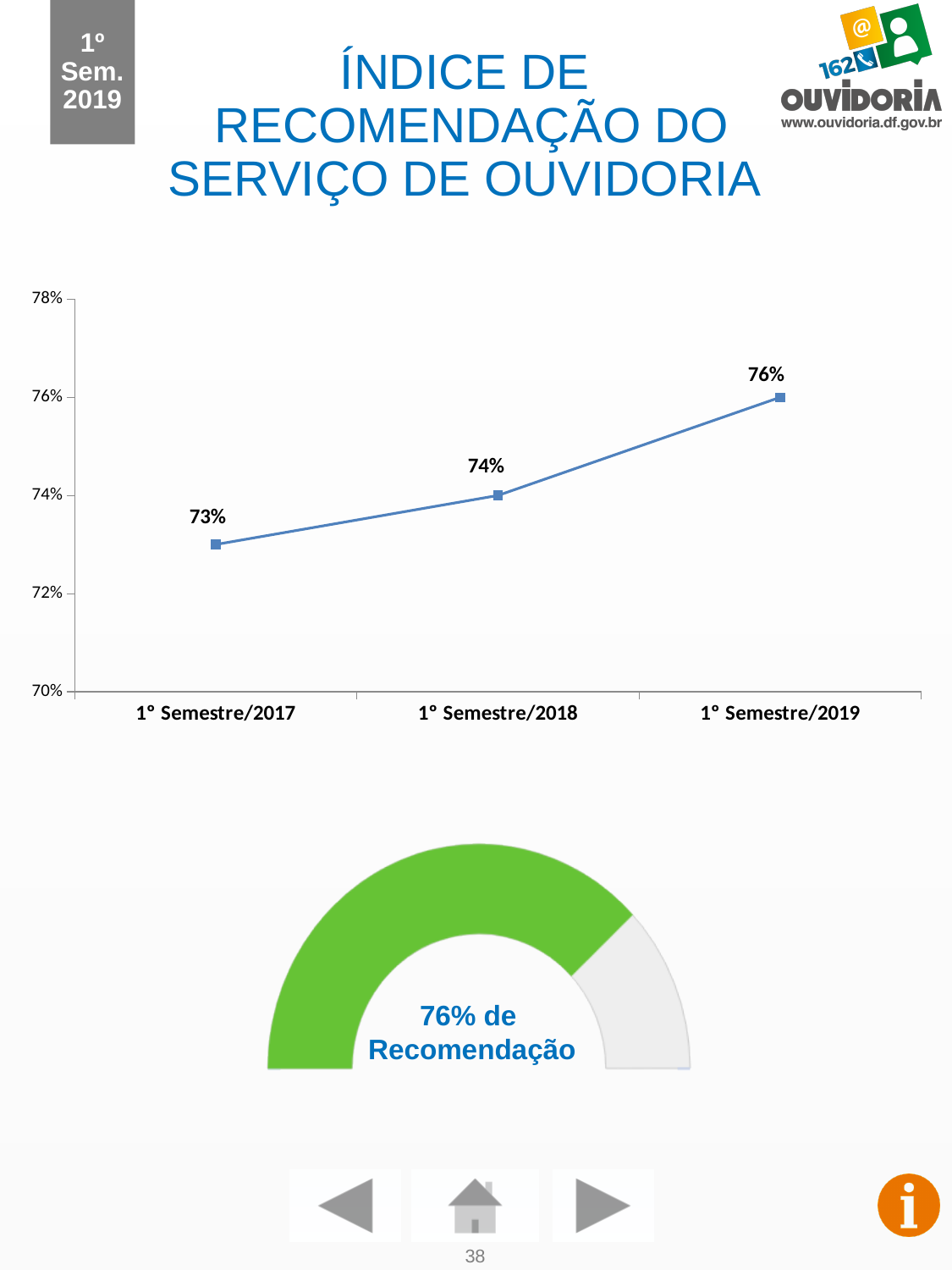
In the line chart, how many data points are plotted? 3 In the line chart, what is the difference between the values for 1° Semestre/2018 and 1° Semestre/2017? 1% In the line chart, which period has the highest value? 1° Semestre/2019 What recommendation percentage does the gauge chart at the bottom of the slide show? 76% In the line chart, what is the difference between the values for 1° Semestre/2019 and 1° Semestre/2017? 3% In the line chart, which period has the lowest value? 1° Semestre/2017 In the line chart, what is the value for 1° Semestre/2017? 73% What kind of chart is the upper chart on the slide? line chart In the line chart, which is larger: the value for 1° Semestre/2018 or 1° Semestre/2019? 1° Semestre/2019 In the line chart, what is the value for 1° Semestre/2018? 74% In the line chart, what is the value for 1° Semestre/2019? 76% In the line chart, do the values rise or fall from 1° Semestre/2017 to 1° Semestre/2019? rise